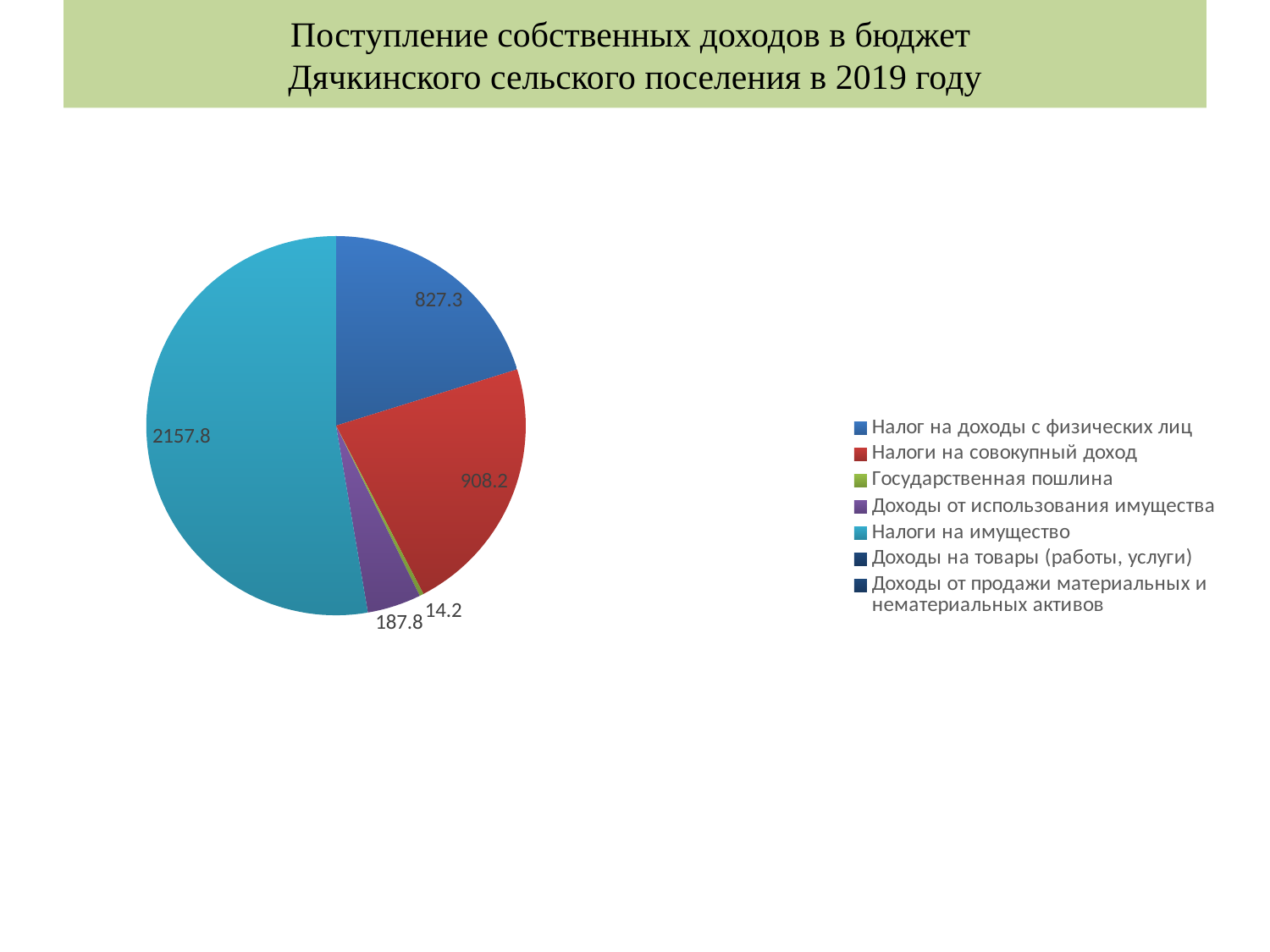
What is the value for Налоги на имущество? 2157.8 Which category has the largest slice of the pie? Налоги на имущество What is the value for Налог на доходы с физических лиц? 827.3 What is the value for Доходы от использования имущества? 187.8 What is the value for Государственная пошлина? 14.2 How many data labels are printed on the pie chart? 5 Which is larger: the value for Налоги на имущество or the value for Налоги на совокупный доход? Налоги на имущество How many entries does the legend list? 7 What is the value for Налоги на совокупный доход? 908.2 Which labelled category has the smallest slice of the pie? Государственная пошлина What type of chart is shown on the slide? pie chart What is the difference between the values for Налоги на совокупный доход and Налог на доходы с физических лиц? 80.9